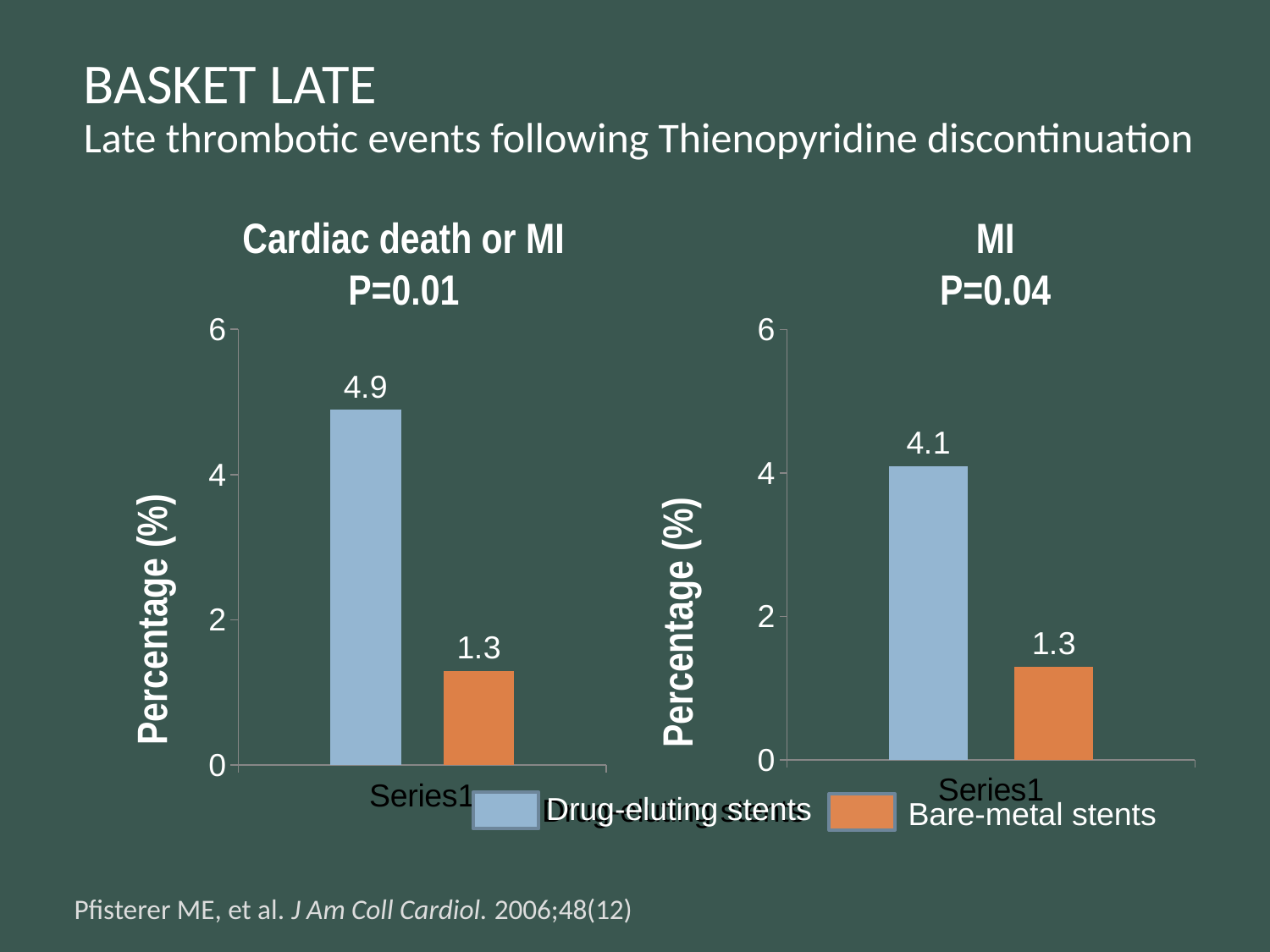
What kind of chart is the 'Cardiac death or MI' chart? bar chart How many series does the legend list? 2 In the 'Cardiac death or MI' chart, what is the difference between the Drug-eluting stents and Bare-metal stents values? 3.6 In the 'Cardiac death or MI' chart, what is the value for Drug-eluting stents? 4.9 In the 'Cardiac death or MI' chart, what is the value for Bare-metal stents? 1.3 In the 'MI' chart, is the value for Drug-eluting stents greater or less than 4? greater In the 'MI' chart, what is the difference between the Drug-eluting stents and Bare-metal stents values? 2.8 Is the Drug-eluting stents value in the 'Cardiac death or MI' chart larger or smaller than the Drug-eluting stents value in the 'MI' chart? larger In the 'MI' chart, what is the value for Bare-metal stents? 1.3 In the 'MI' chart, which stent type has the lower value? Bare-metal stents In the 'MI' chart, what is the value for Drug-eluting stents? 4.1 In the 'Cardiac death or MI' chart, which stent type has the higher value? Drug-eluting stents